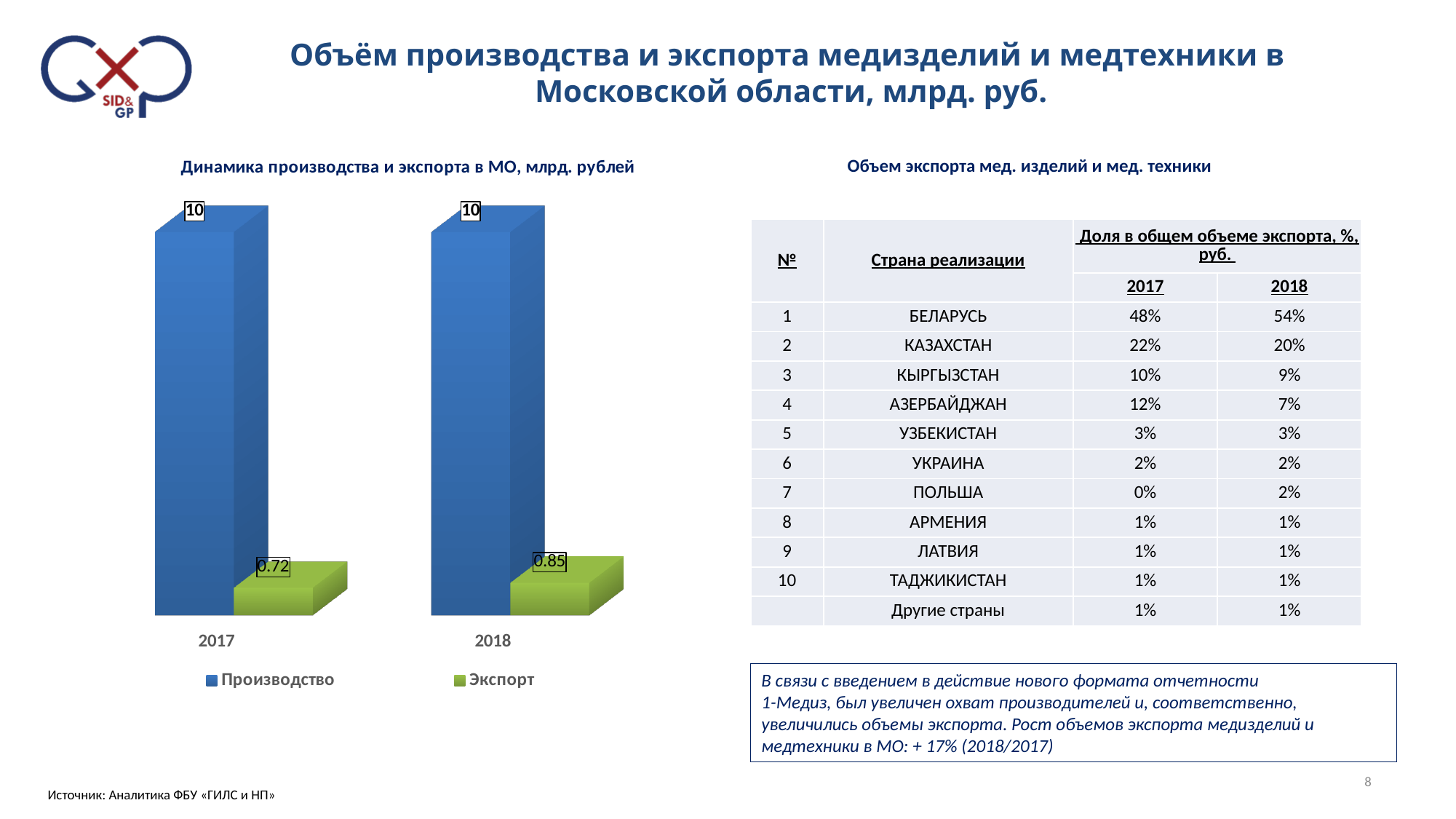
What is the value of Производство for 2018 in the chart? 10 By how much did Экспорт increase from 2017 to 2018 in the chart? 0.13 Which year has the larger Экспорт value in the chart, 2017 or 2018? 2018 What type of chart is shown on the left of the slide? bar chart What is the value of Экспорт for 2018 in the chart? 0.85 What is the difference between Производство and Экспорт for 2018 in the chart? 9.15 What is the title of the chart on the left of the slide? Динамика производства и экспорта в МО, млрд. рублей What is the value of Экспорт for 2017 in the chart? 0.72 How many series does the chart legend list? 2 How many years (categories) are shown on the x axis of the chart? 2 What is the value of Производство for 2017 in the chart? 10 Does the Экспорт value rise or fall from 2017 to 2018 in the chart? rise